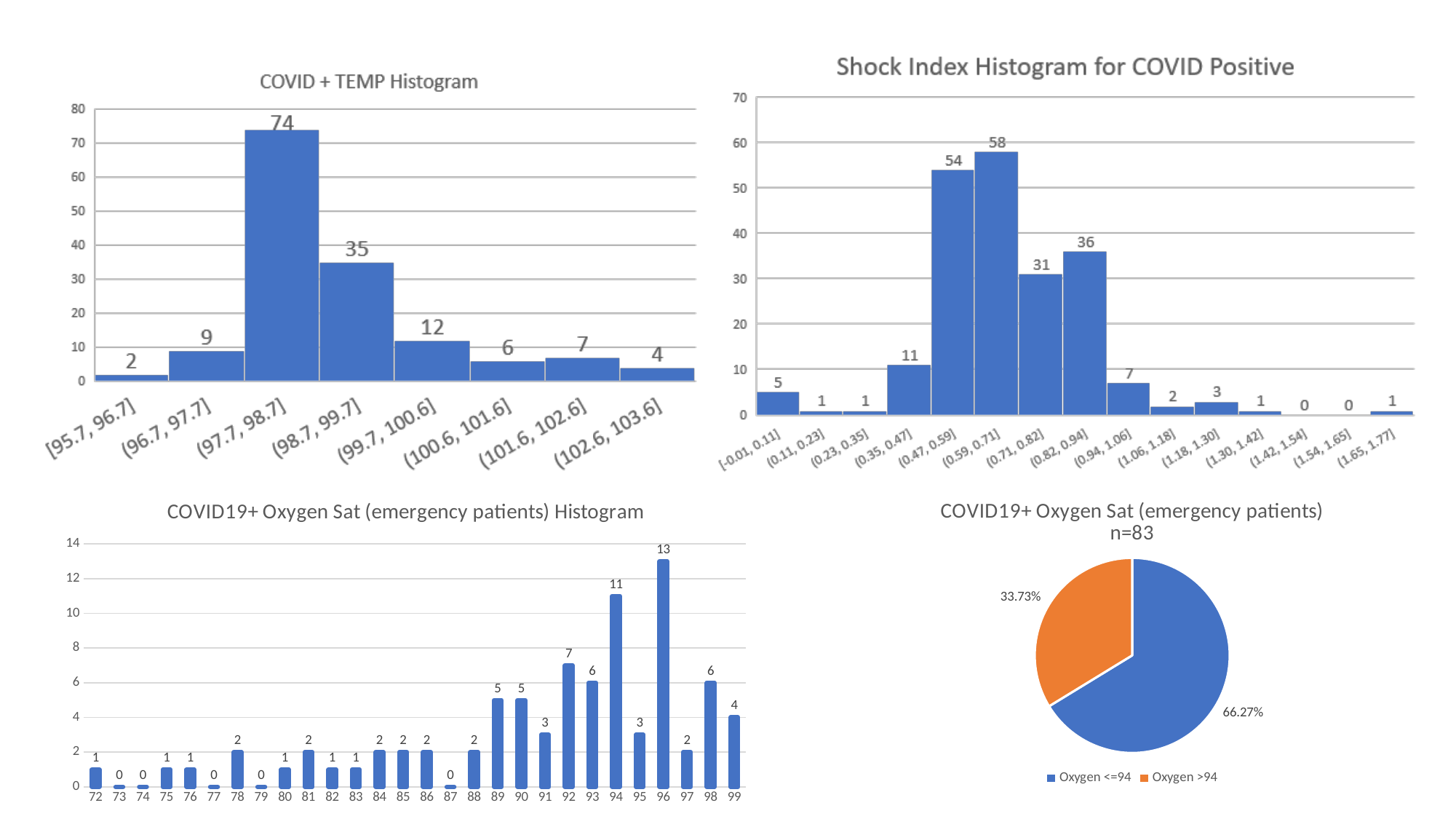
In the Shock Index Histogram for COVID Positive, which is larger: the (0.47, 0.59] bin or the (0.71, 0.82] bin? (0.47, 0.59] In the COVID + TEMP Histogram, which bin has the lowest value? [95.7, 96.7] In the COVID19+ Oxygen Sat (emergency patients) Histogram, what is the difference between the values for 94 and 92? 4 In the COVID + TEMP Histogram, what is the difference between the (97.7, 98.7] bin and the (98.7, 99.7] bin? 39 In the Shock Index Histogram for COVID Positive, which bin has the highest value? (0.59, 0.71] How many series does the legend of the COVID19+ Oxygen Sat (emergency patients) pie chart list? 2 How many bins are shown in the COVID + TEMP Histogram? 8 In the COVID19+ Oxygen Sat (emergency patients) pie chart, what share is Oxygen >94? 33.73% What kind of chart is the Shock Index Histogram for COVID Positive? Bar chart In the COVID19+ Oxygen Sat (emergency patients) Histogram, what is the value for 96? 13 In the Shock Index Histogram for COVID Positive, what is the value for the (0.82, 0.94] bin? 36 In the COVID + TEMP Histogram, what is the value for the (97.7, 98.7] bin? 74